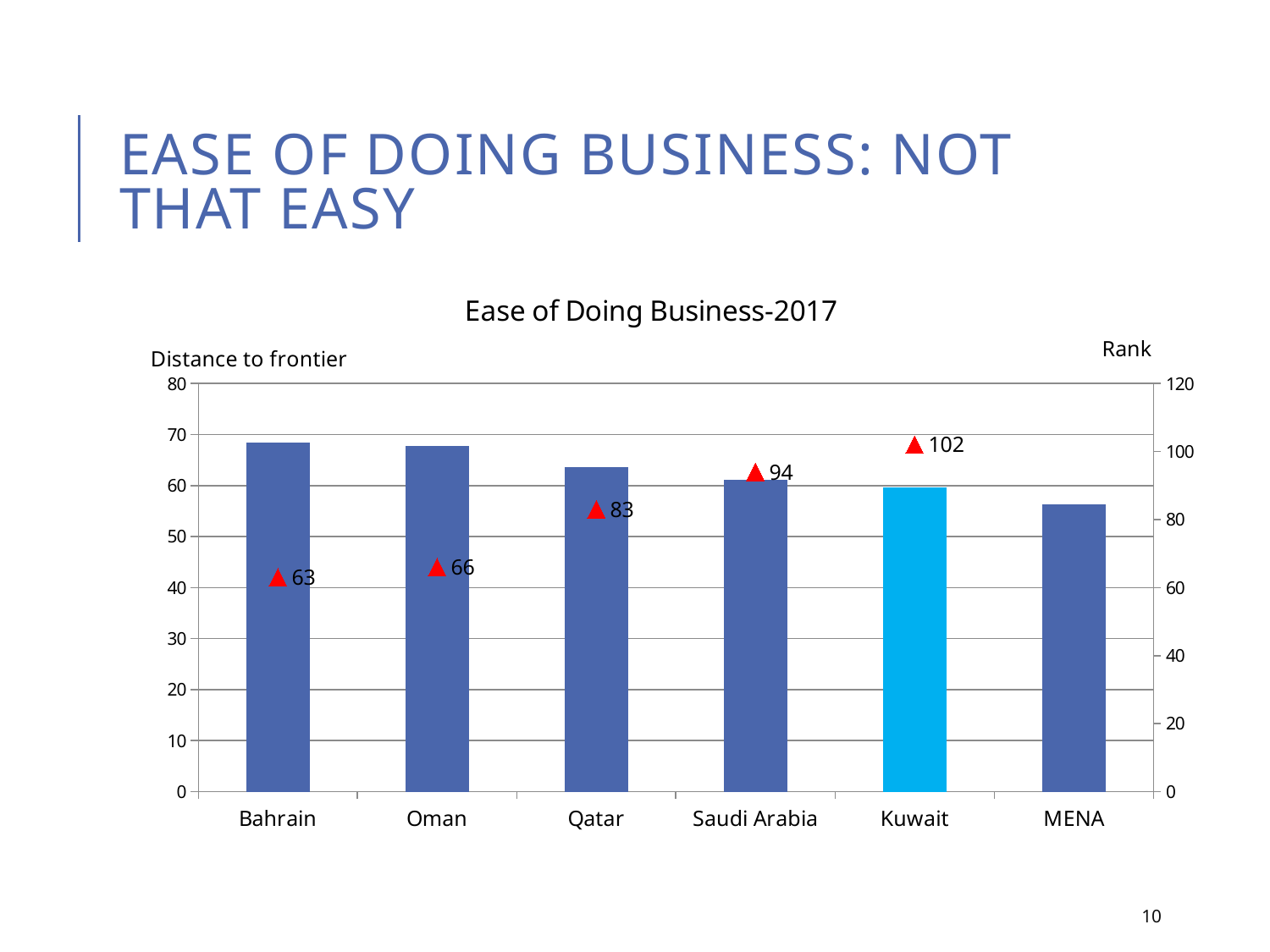
Which country has the highest rank value marked on the chart? Kuwait Which country has the lowest rank value marked on the chart? Bahrain What is the rank shown for Saudi Arabia? 94 Which bar is shown in a different colour from the others? Kuwait How many categories are shown on the x axis? 6 Is the distance to frontier bar for MENA greater or less than 60? less Is the distance to frontier bar for Bahrain greater or less than 60? greater What is the rank shown for Bahrain? 63 What is the difference between the rank of Kuwait and the rank of Bahrain? 39 Which has a higher rank value, Qatar or Oman? Qatar What is the rank shown for Kuwait? 102 Which category has the lowest distance to frontier bar? MENA